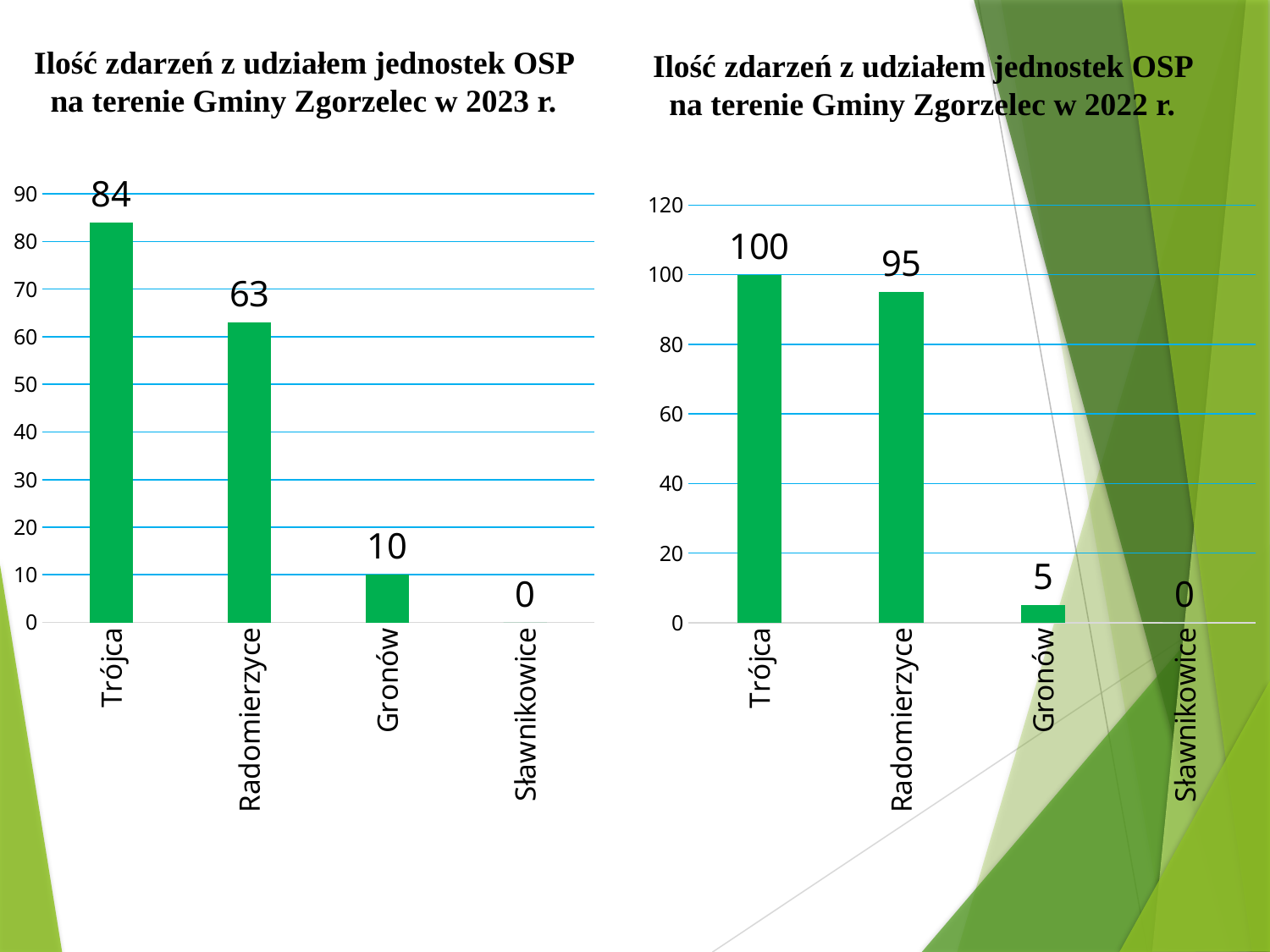
In the 2022 chart (right), what is the value for Radomierzyce? 95 In the 2023 chart (left), what is the value for Radomierzyce? 63 In the 2022 chart (right), do the values rise or fall from left to right along the x axis? fall In the 2023 chart (left), which category has the highest value? Trójca In the 2022 chart (right), what is the value for Gronów? 5 In the 2023 chart (left), which is larger, the value for Gronów or the value for Sławnikowice? Gronów What kind of chart is the 2023 chart (left)? bar chart In the 2023 chart (left), what is the value for Trójca? 84 In the 2023 chart (left), what is the difference between the values for Trójca and Radomierzyce? 21 In the 2022 chart (right), which category has the lowest value? Sławnikowice How many categories are shown in the 2022 chart (right)? 4 In the 2022 chart (right), what is the difference between the values for Trójca and Gronów? 95